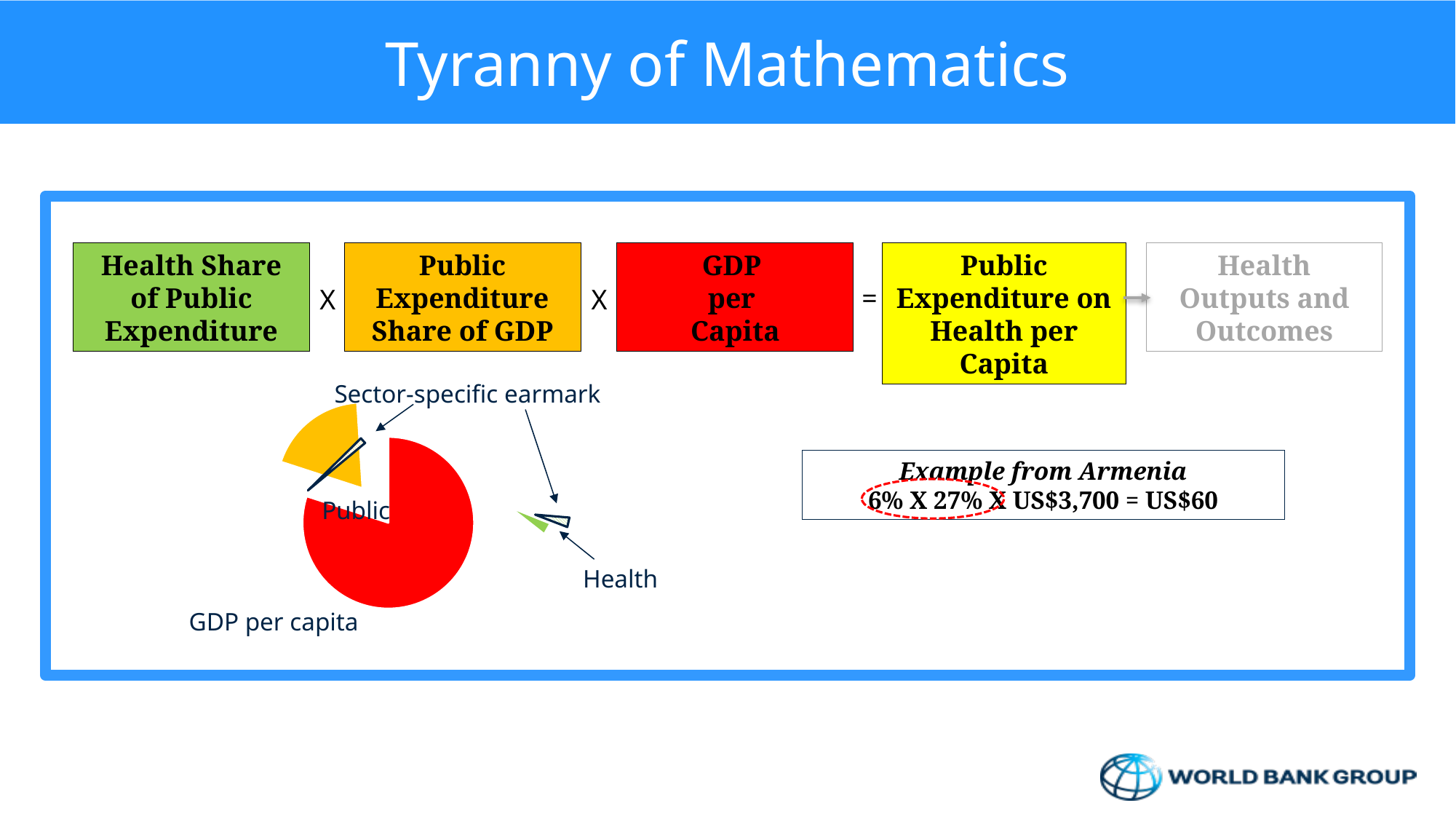
Which slice of the pie chart is the largest? GDP per capita What colour is the GDP per capita slice of the pie chart? Red Which slice of the pie chart is larger, Public or Health? Public Which slice of the pie chart is smaller, Health or GDP per capita? Health What colour is the Health slice of the pie chart? Green Does the GDP per capita slice take up more or less than half of the pie chart? More What kind of chart is shown on the slide? Pie chart Which slice of the pie chart is larger, GDP per capita or Public? GDP per capita